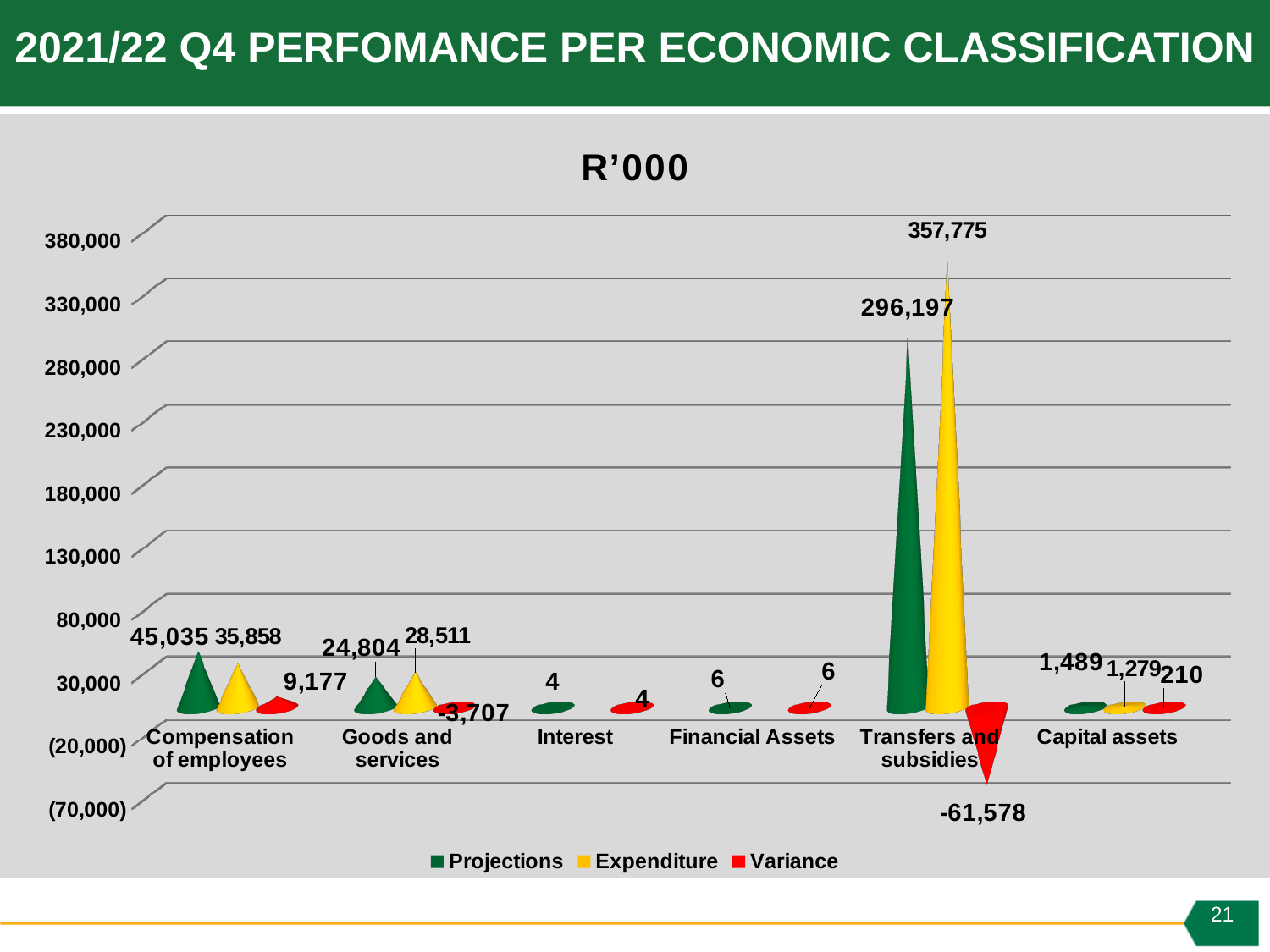
What is the Projections value for Transfers and subsidies? 296,197 What kind of chart is shown on the slide? Bar chart What is the Variance value for Transfers and subsidies? -61,578 Which is larger for Goods and services, Projections or Expenditure? Expenditure Which category has the highest Expenditure value? Transfers and subsidies What is the Expenditure value for Goods and services? 28,511 How many series does the legend list? 3 How many categories are shown on the x axis? 6 What is the Variance value for Compensation of employees? 9,177 What is the Projections value for Capital assets? 1,489 What is the Expenditure value for Transfers and subsidies? 357,775 What is the difference between Projections and Expenditure for Compensation of employees? 9,177